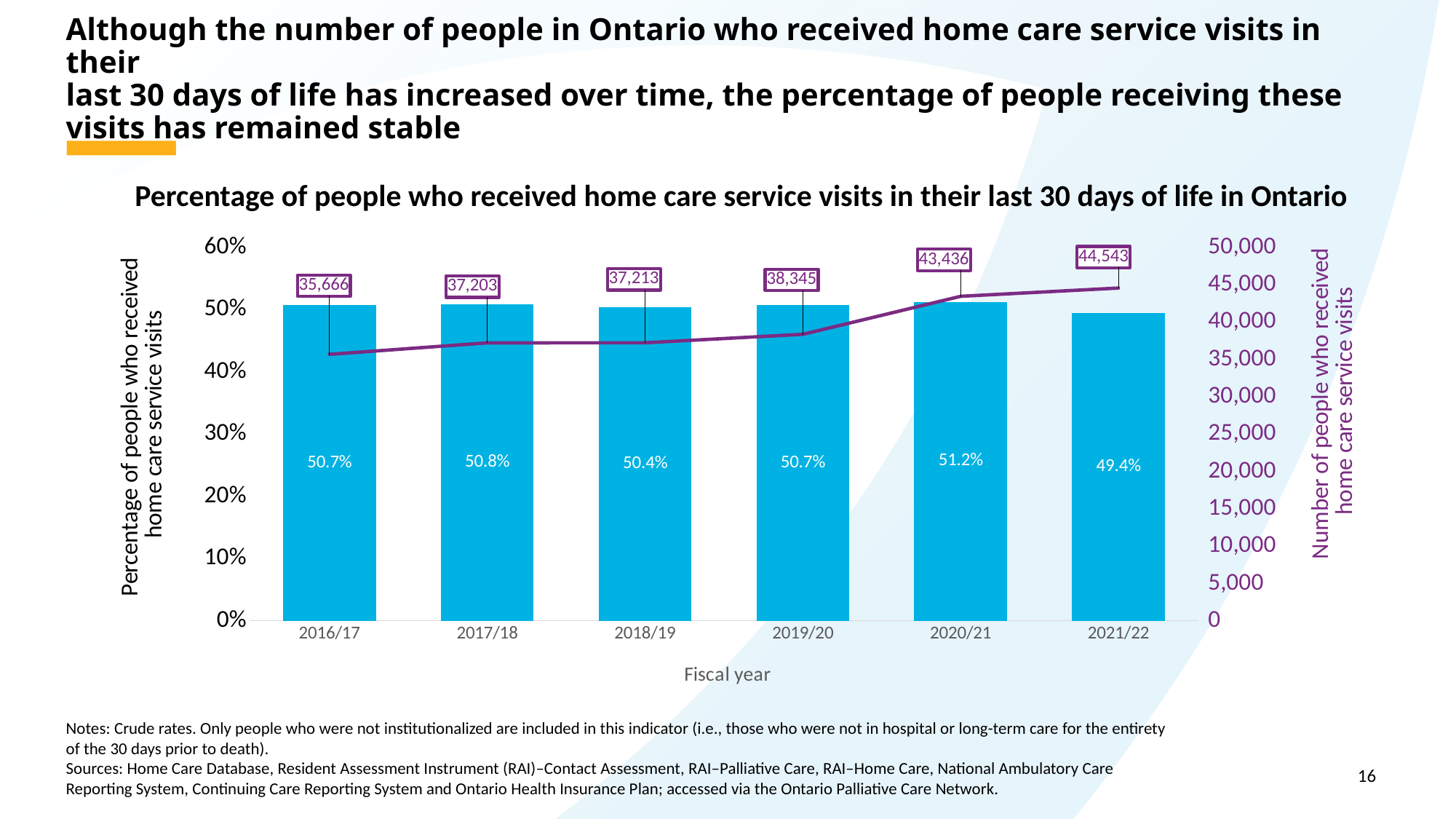
What is the difference in percentage points between the 2020/21 and 2021/22 bars? 1.8 What percentage of people received home care service visits in their last 30 days of life in 2020/21? 51.2% How many fiscal years are shown on the x axis of the chart? 6 Is the number of people who received home care service visits in 2016/17 greater or less than 40,000? less What percentage of people received home care service visits in their last 30 days of life in 2016/17? 50.7% Which fiscal year has the lowest percentage of people receiving home care service visits? 2021/22 What is the label of the x axis of the chart? Fiscal year How many people received home care service visits in their last 30 days of life in 2021/22? 44,543 What is the difference in the number of people who received home care service visits between 2020/21 and 2019/20? 5,091 Does the number of people who received home care service visits rise or fall from 2016/17 to 2021/22? rise Which fiscal year has the highest number of people who received home care service visits? 2021/22 Which fiscal year has the higher percentage of people receiving home care service visits, 2018/19 or 2020/21? 2020/21